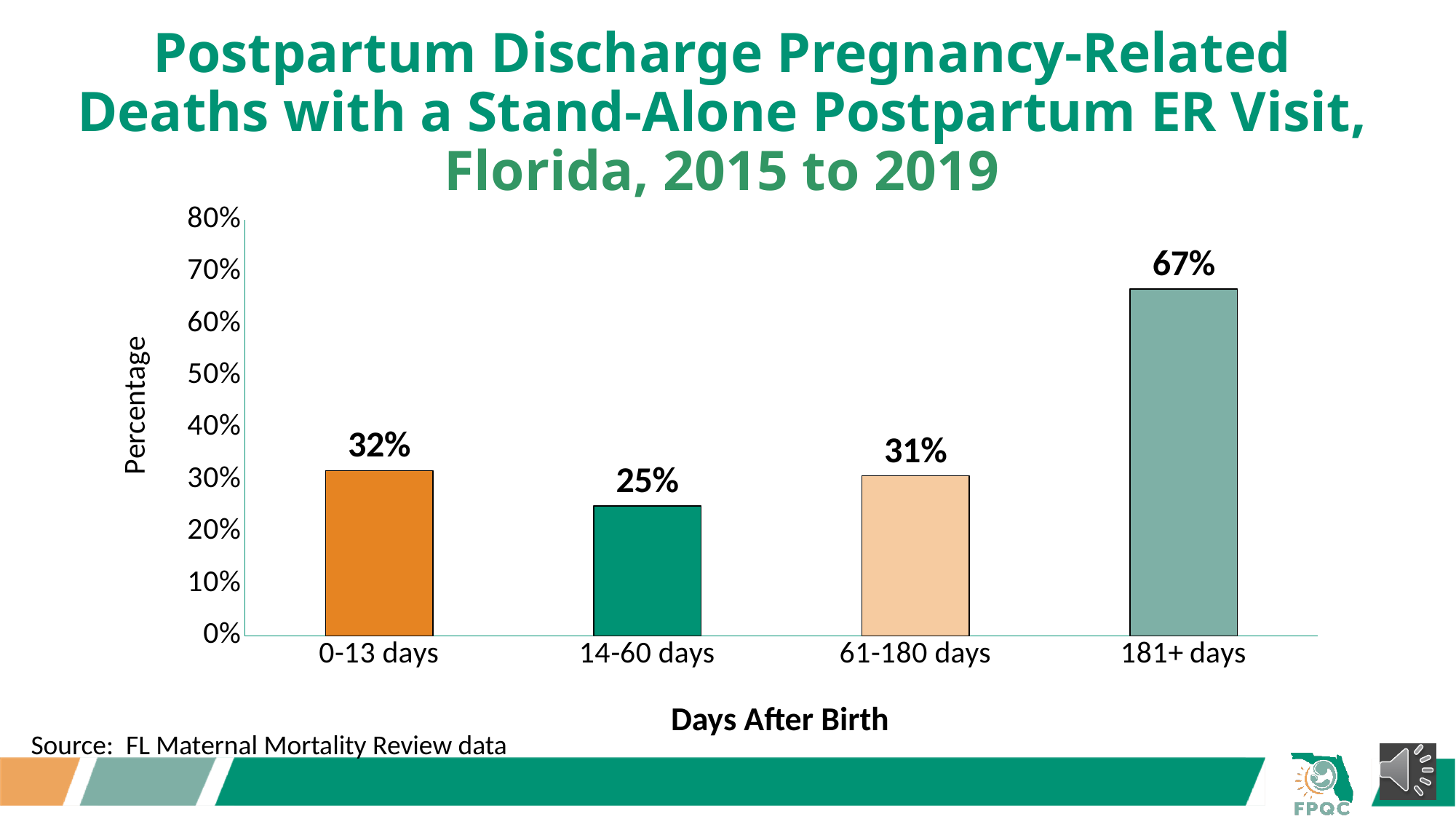
How many days-after-birth categories are shown on the chart? 4 Which days-after-birth category has the highest percentage? 181+ days What is the percentage for 14-60 days? 25% What is the percentage for 61-180 days? 31% What is the difference in percentage points between 181+ days and 0-13 days? 35 Which has a higher percentage, 0-13 days or 61-180 days? 0-13 days What is the label of the x axis? Days After Birth What is the difference in percentage points between 0-13 days and 14-60 days? 7 Which days-after-birth category has the lowest percentage? 14-60 days What is the percentage for 0-13 days? 32% What kind of chart is shown on the slide? Bar chart What is the percentage for 181+ days? 67%